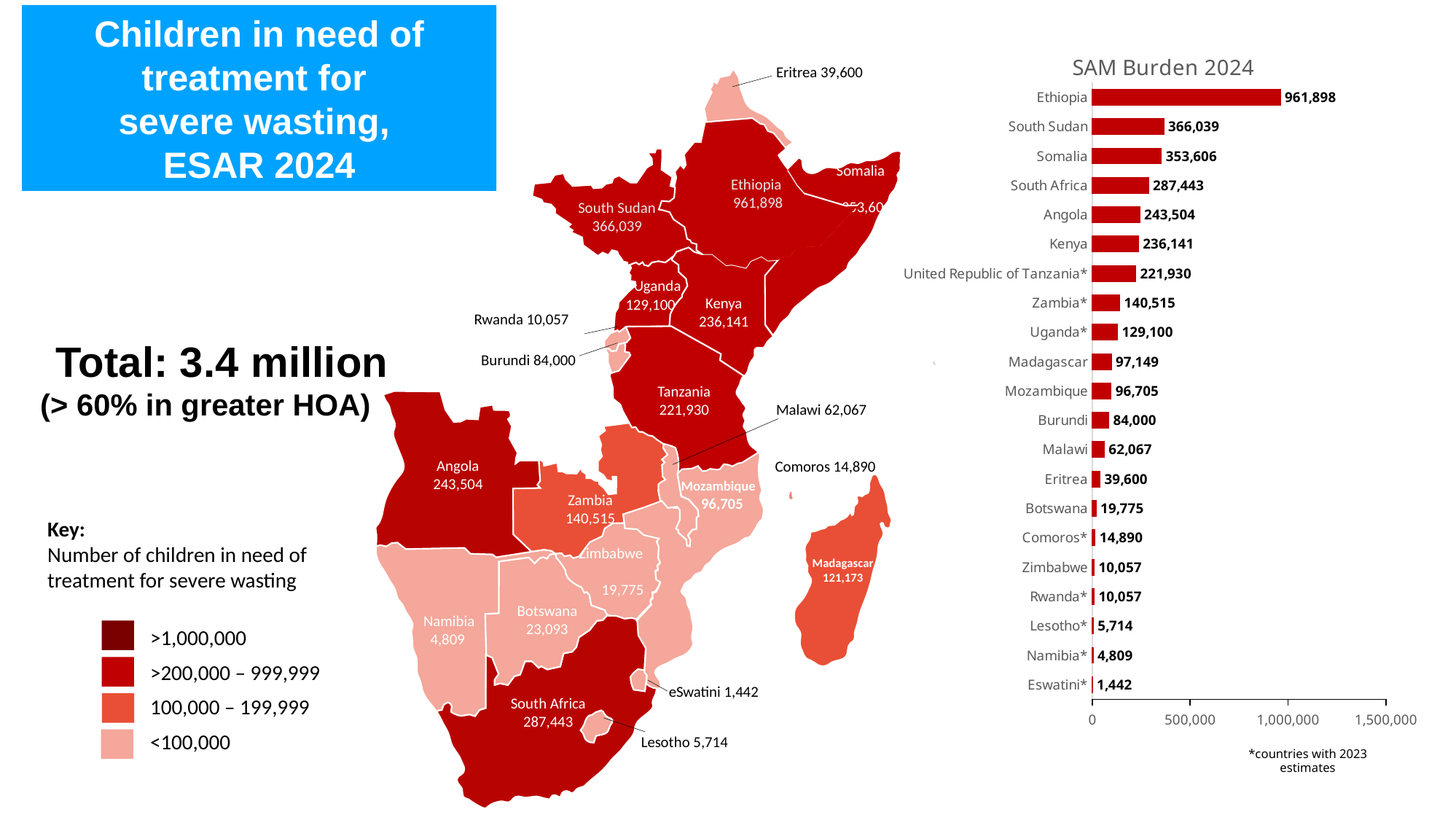
In the SAM Burden 2024 bar chart, what is the value for Burundi? 84,000 How many countries are listed in the SAM Burden 2024 bar chart? 21 In the SAM Burden 2024 bar chart, which country has the highest value? Ethiopia In the SAM Burden 2024 bar chart, which is larger, the value for Angola or the value for Kenya? Angola In the SAM Burden 2024 bar chart, which country has the lowest value? Eswatini* In the SAM Burden 2024 bar chart, what is the value for Ethiopia? 961,898 What kind of chart is the SAM Burden 2024 chart? bar chart In the SAM Burden 2024 bar chart, what is the value for Kenya? 236,141 In the SAM Burden 2024 bar chart, is the value for Ethiopia greater or less than 500,000? greater What is the title of the bar chart on the right of the slide? SAM Burden 2024 In the SAM Burden 2024 bar chart, what is the difference between the values for South Sudan and Somalia? 12,433 In the SAM Burden 2024 bar chart, what is the value for Zambia*? 140,515